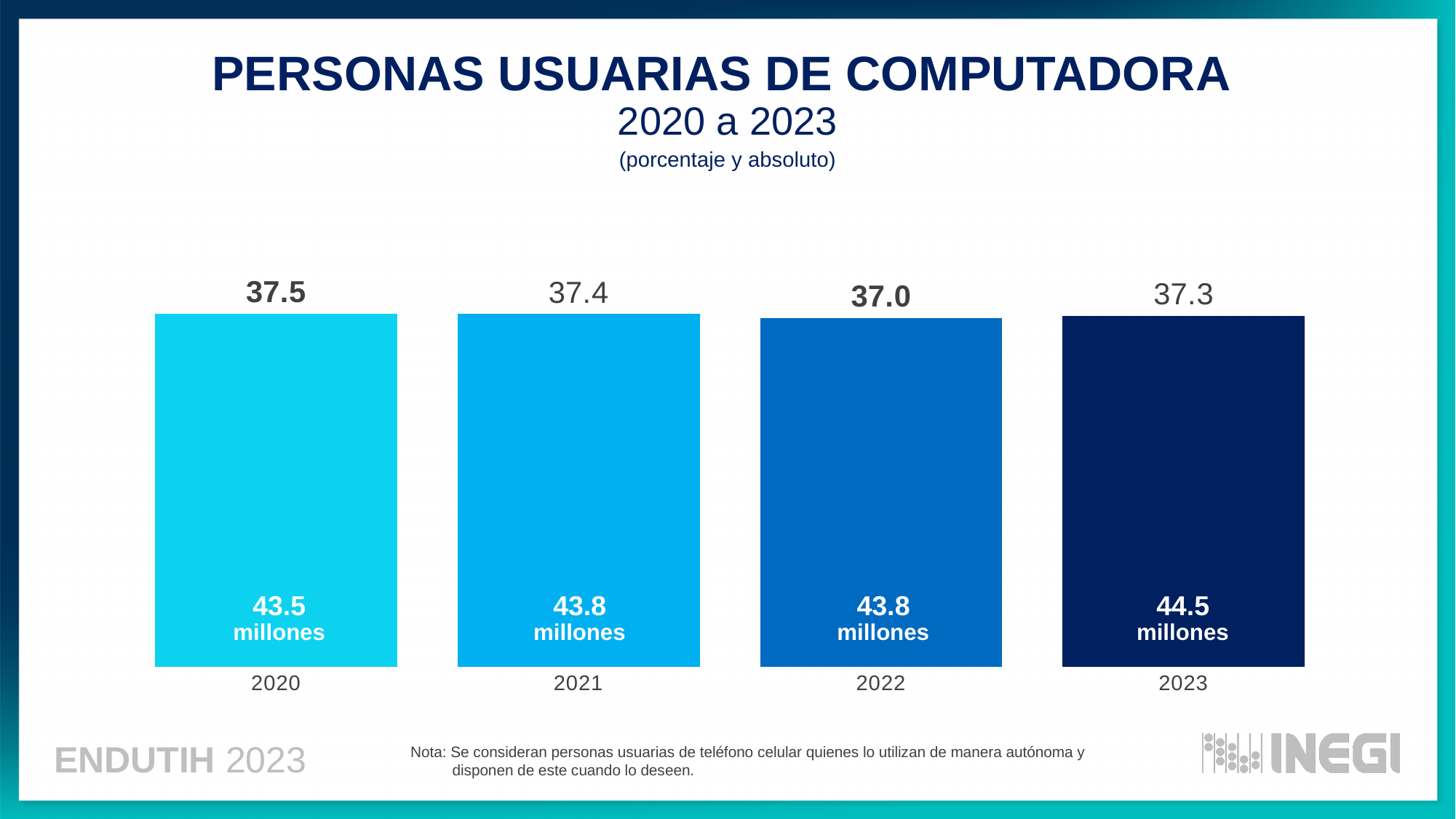
Which year has the highest absolute number of users in millions? 2023 What percentage is shown for 2020? 37.5 How many millions of computer users are shown for 2023? 44.5 millones How many millions of computer users are shown for 2020? 43.5 millones Which year has the lowest percentage label? 2022 Which is larger, the percentage for 2021 or for 2023? 2021 What is the difference in millions of users between 2023 and 2020? 1.0 millones What percentage is shown for 2022? 37.0 Which year has the highest percentage label? 2020 What kind of chart is shown on the slide? Bar chart What is the difference in percentage points between 2020 and 2022? 0.5 How many years are shown in the chart? 4